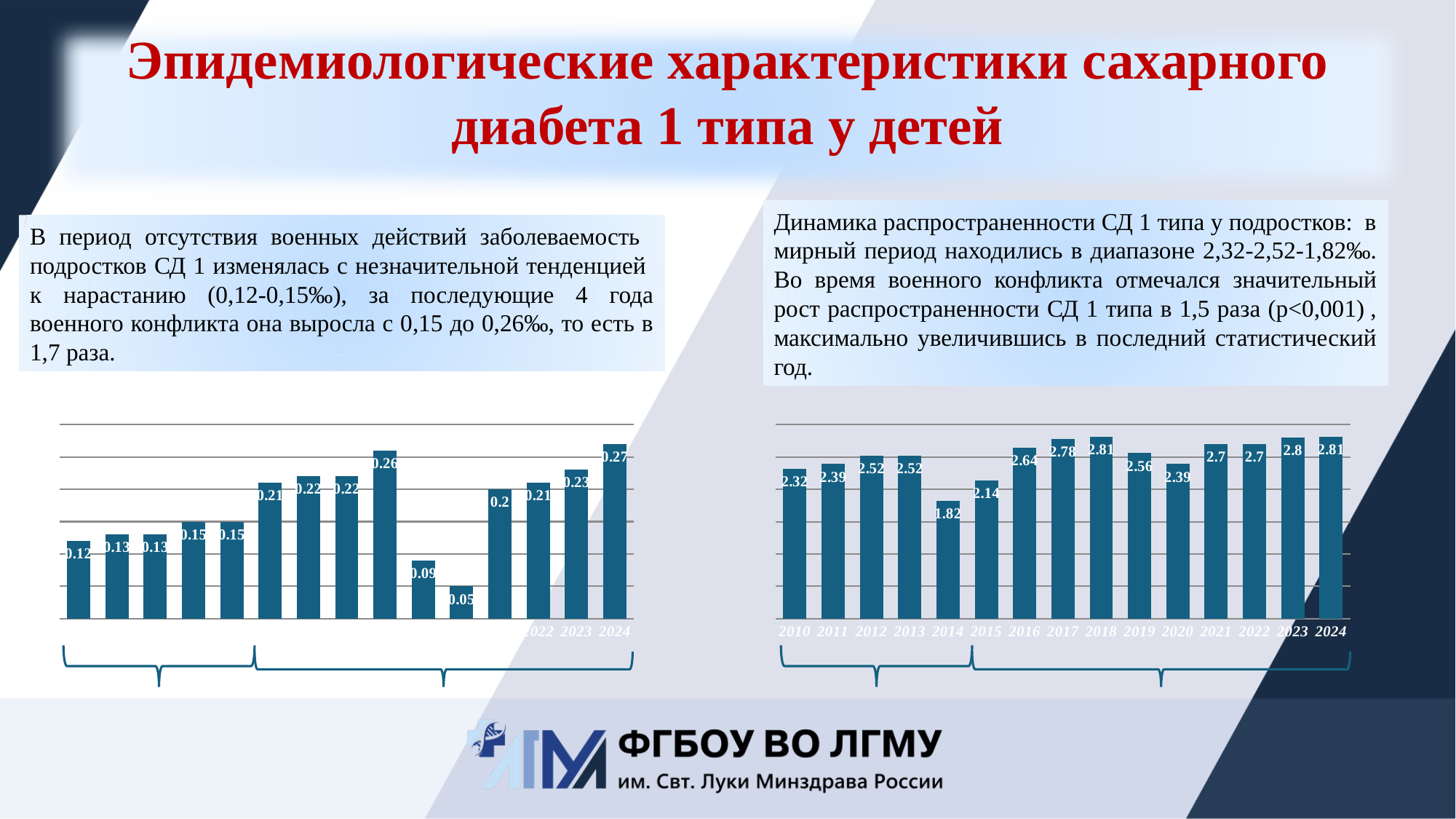
In the left chart, what is the value for 2023? 0.23 In the right chart, what is the value for 2014? 1.82 In the left chart, what is the value for 2024? 0.27 In the right chart, what is the difference between the values for 2024 and 2010? 0.49 In the left chart, how many bars are plotted? 15 In the right chart, what is the highest value shown? 2.81 In the right chart, what is the value for 2010? 2.32 In the left chart, what is the lowest value shown? 0.05 In the right chart, how many years are plotted? 15 In the right chart, which is larger, the value for 2017 or the value for 2015? 2017 What type of chart is the left chart? Bar chart In the right chart, which year has the lowest value? 2014